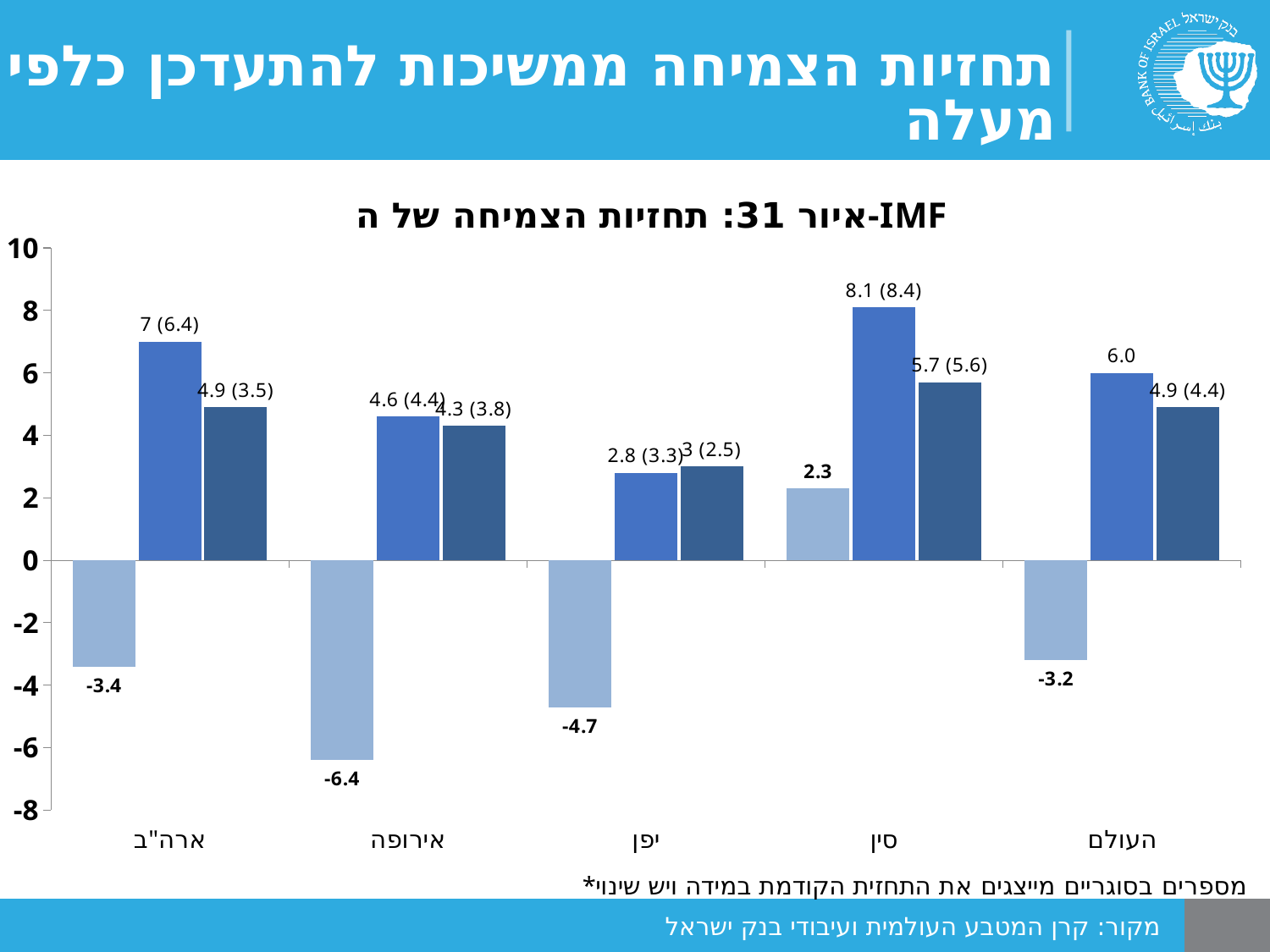
Which category has the highest value among the medium blue (middle) bars? סין What kind of chart is shown on the slide? bar chart Which category has the lowest value among the light blue bars? אירופה What is the data label on the light blue bar for יפן? -4.7 What is the data label on the medium blue (middle) bar for סין? 8.1 (8.4) What is the data label on the light blue bar for אירופה? -6.4 What is the title of the chart? איור 31: תחזיות הצמיחה של ה-IMF Which category is the only one with a positive light blue bar? סין Is the medium blue bar for ארה"ב larger or smaller than the medium blue bar for אירופה? larger What is the data label on the dark blue (right) bar for העולם? 4.9 (4.4) What is the data label on the light blue bar for ארה"ב? -3.4 How many categories (countries/regions) are shown on the x axis? 5